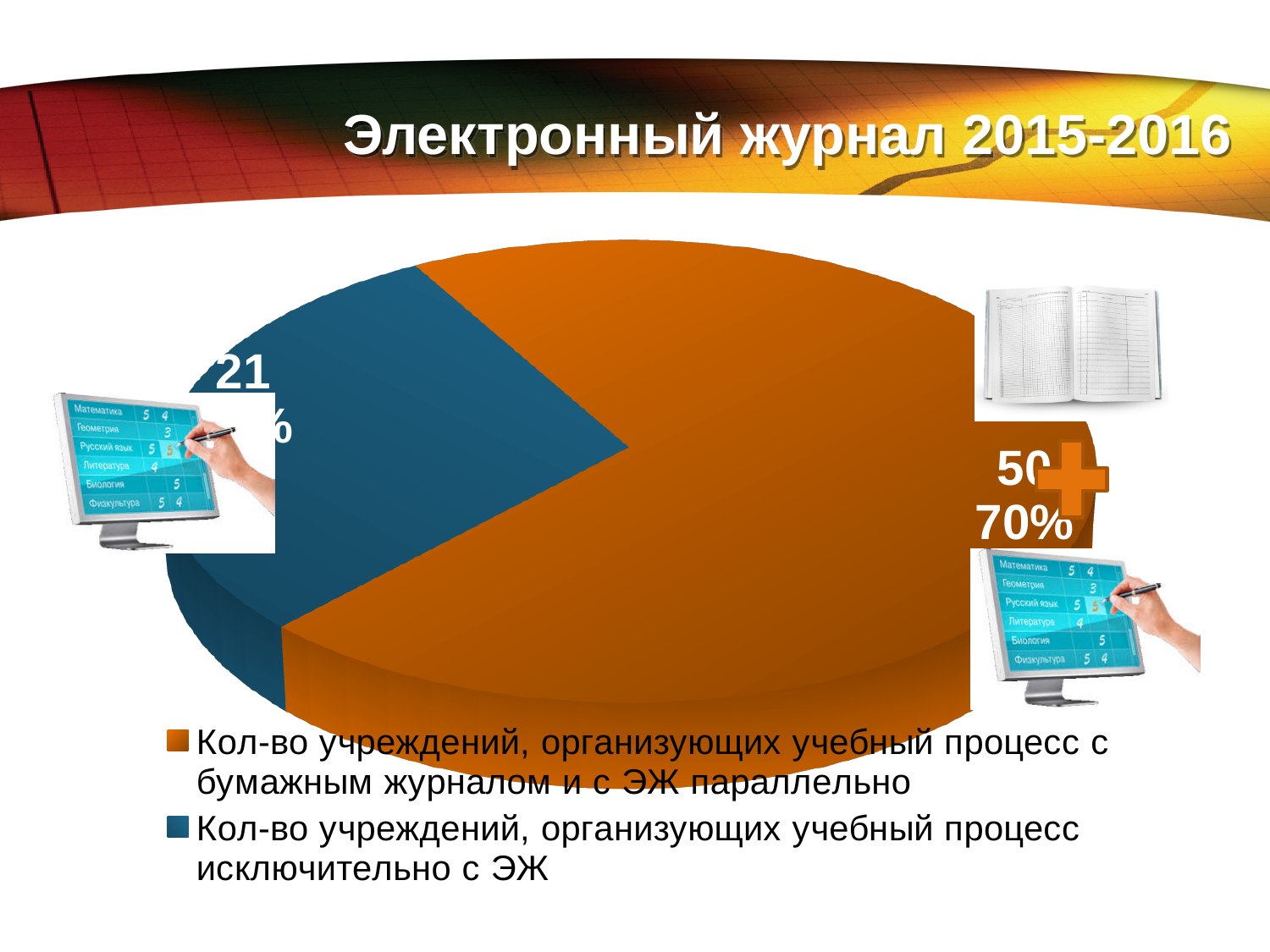
Which category has the smallest slice of the pie chart? Кол-во учреждений, организующих учебный процесс исключительно с ЭЖ How many slices does the pie chart have? 2 Which category has the largest slice of the pie chart? Кол-во учреждений, организующих учебный процесс с бумажным журналом и с ЭЖ параллельно How many entries does the legend of the pie chart list? 2 What share of the pie is labelled for institutions using a paper journal and the electronic journal in parallel? 70% What is the title of the slide containing the pie chart? Электронный журнал 2015-2016 What colour is the slice for institutions organising the educational process exclusively with the electronic journal (исключительно с ЭЖ)? blue What value is labelled on the slice for institutions organising the educational process exclusively with the electronic journal (исключительно с ЭЖ)? 21 What kind of chart is shown on the slide? pie chart Which slice is larger: institutions using a paper journal and ЭЖ in parallel, or institutions using exclusively ЭЖ? institutions using a paper journal and ЭЖ in parallel